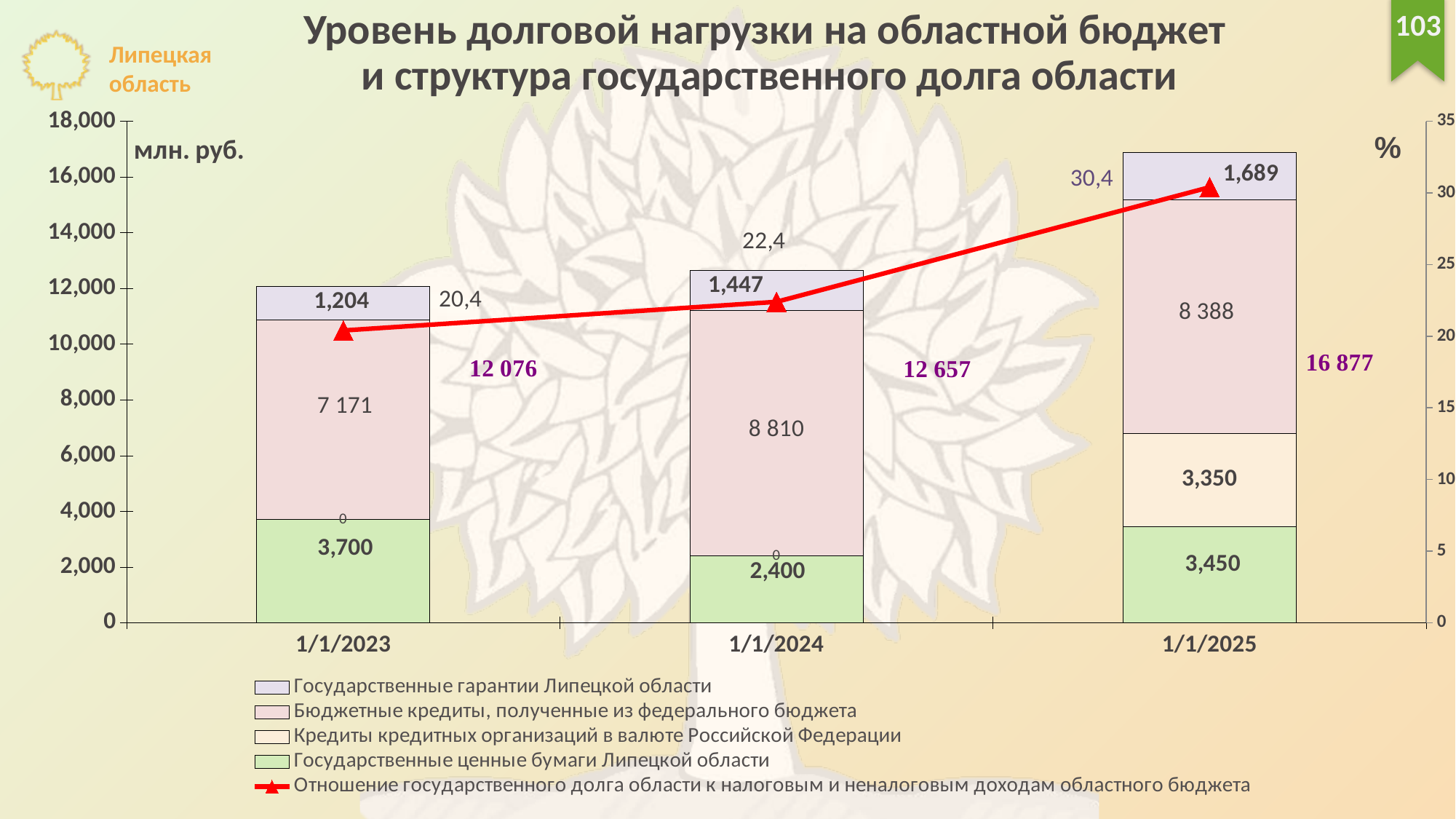
What is the value of Государственные гарантии Липецкой области on 1/1/2025? 1,689 Does the debt ratio line rise or fall from 1/1/2023 to 1/1/2025? rise On which date is the value of Государственные ценные бумаги Липецкой области the lowest? 1/1/2024 What is the total state debt shown for 1/1/2025? 16 877 What is the difference between the total debt on 1/1/2025 and on 1/1/2024? 4 220 What is the value of Бюджетные кредиты, полученные из федерального бюджета on 1/1/2024? 8 810 What is the ratio of state debt to tax and non-tax revenues (Отношение государственного долга...) on 1/1/2024? 22,4 How many series does the legend list? 5 What is the value of Государственные ценные бумаги Липецкой области on 1/1/2023? 3,700 What kind of chart is shown on the slide? stacked bar chart with a line What is the value of Кредиты кредитных организаций в валюте Российской Федерации on 1/1/2025? 3,350 On which date is the total state debt the highest? 1/1/2025